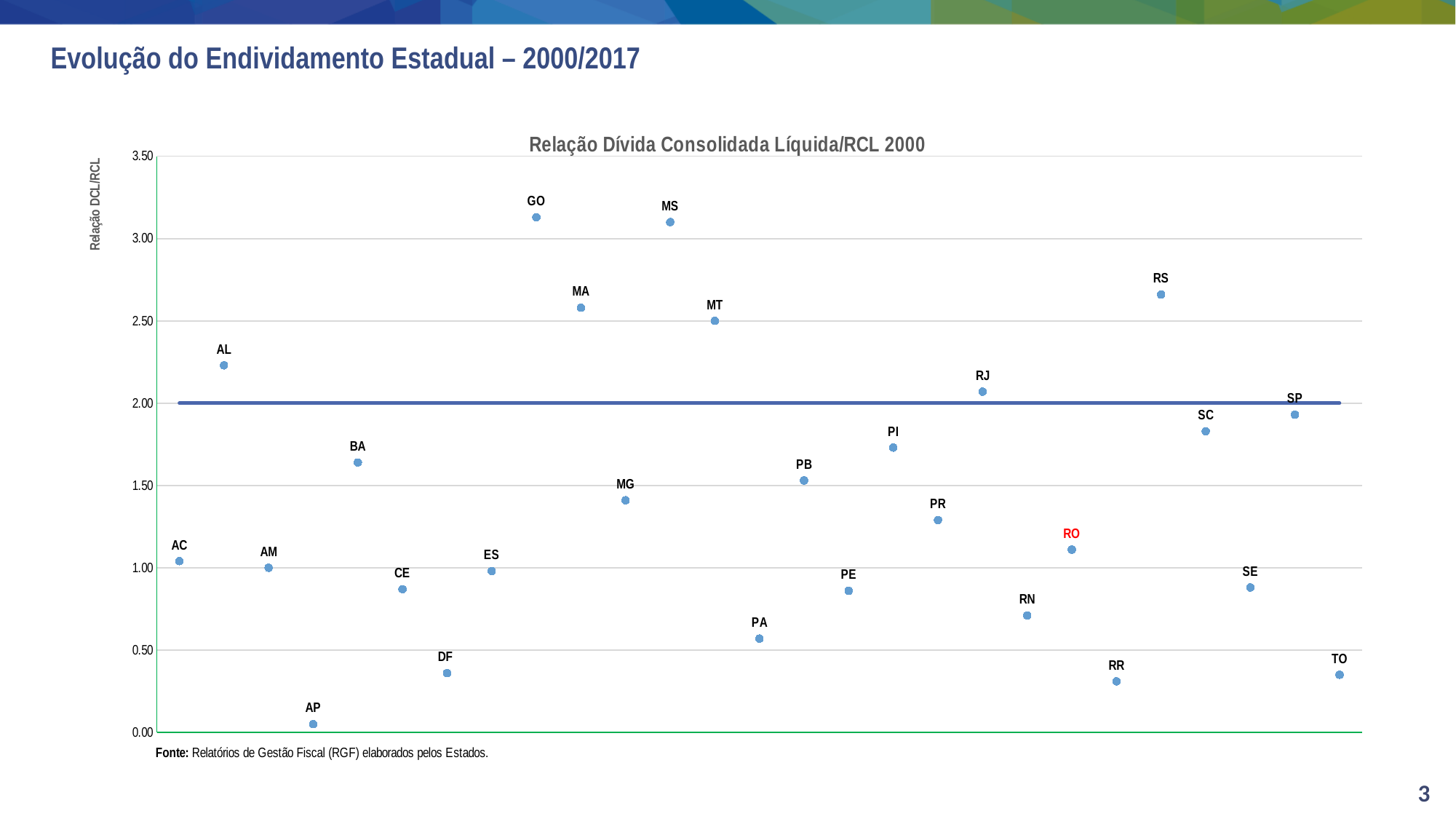
Which state label is shown in red in the chart? RO Which has the larger value, BA or CE? BA Which state has the lowest value in the chart? AP Which has the larger value, RS or RJ? RS Is the value for GO greater or less than 3.00? greater How many states are plotted in the chart? 27 What kind of chart is shown on the slide? scatter chart Is the value for AL greater or less than 2.00? greater What is the title of the chart? Relação Dívida Consolidada Líquida/RCL 2000 Is the value for SC greater or less than 2.00? less